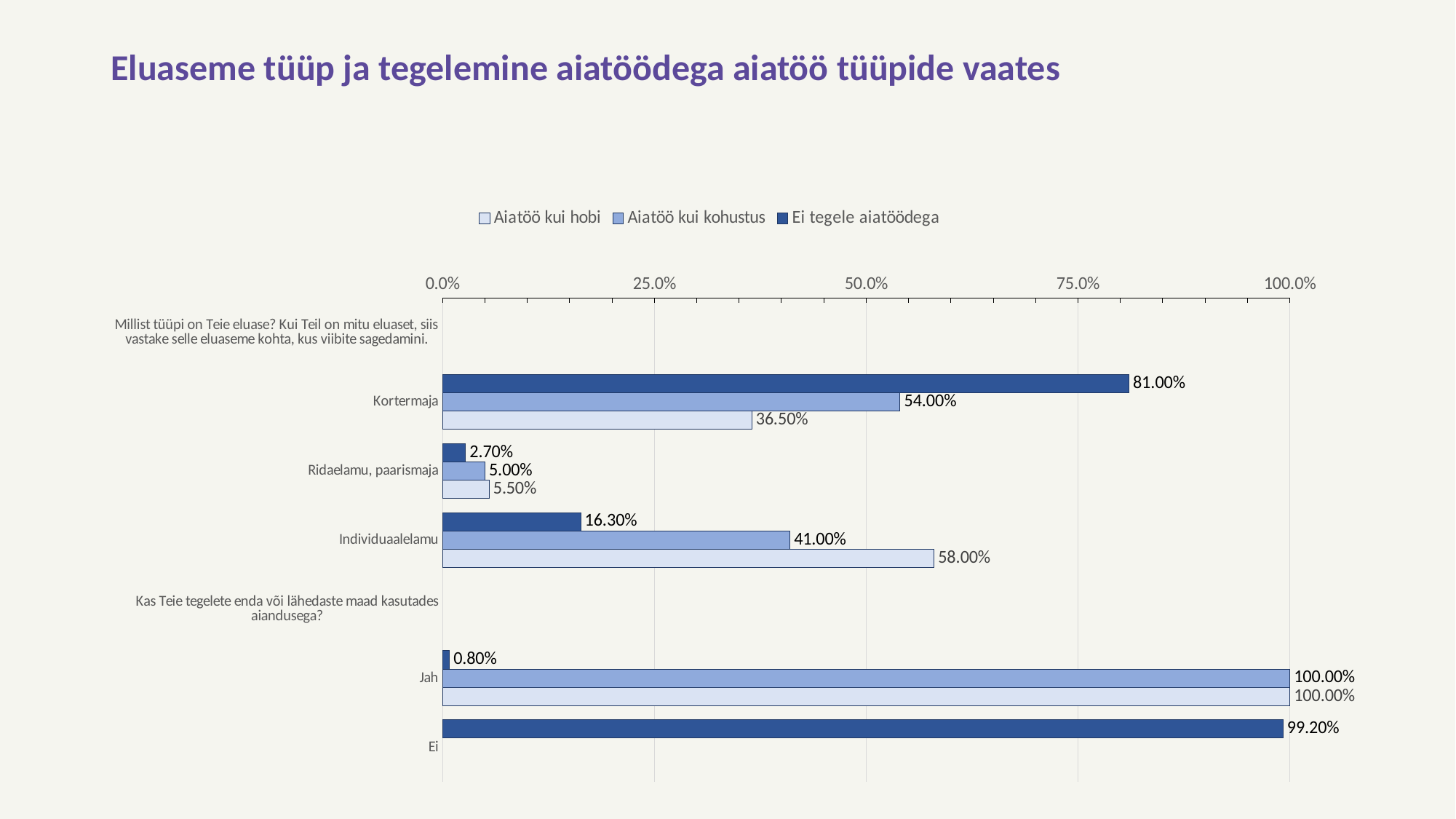
How many series does the legend list? 3 For Individuaalelamu, which is larger: the 'Aiatöö kui kohustus' value or the 'Ei tegele aiatöödega' value? Aiatöö kui kohustus Which housing type has the highest value in the 'Aiatöö kui hobi' series: Kortermaja, Ridaelamu, paarismaja or Individuaalelamu? Individuaalelamu What is the value for Kortermaja in the 'Ei tegele aiatöödega' series? 81.00% Which housing type has the lowest value in the 'Ei tegele aiatöödega' series: Kortermaja, Ridaelamu, paarismaja or Individuaalelamu? Ridaelamu, paarismaja What is the difference between the 'Ei tegele aiatöödega' and 'Aiatöö kui hobi' values for Kortermaja? 44.50% What is the value for Jah in the 'Ei tegele aiatöödega' series? 0.80% What is the value for Individuaalelamu in the 'Aiatöö kui hobi' series? 58.00% What is the value for Ei in the 'Ei tegele aiatöödega' series? 99.20% What is the title of the chart slide? Eluaseme tüüp ja tegelemine aiatöödega aiatöö tüüpide vaates What is the value for Ridaelamu, paarismaja in the 'Aiatöö kui kohustus' series? 5.00% What kind of chart is shown on the slide? bar chart